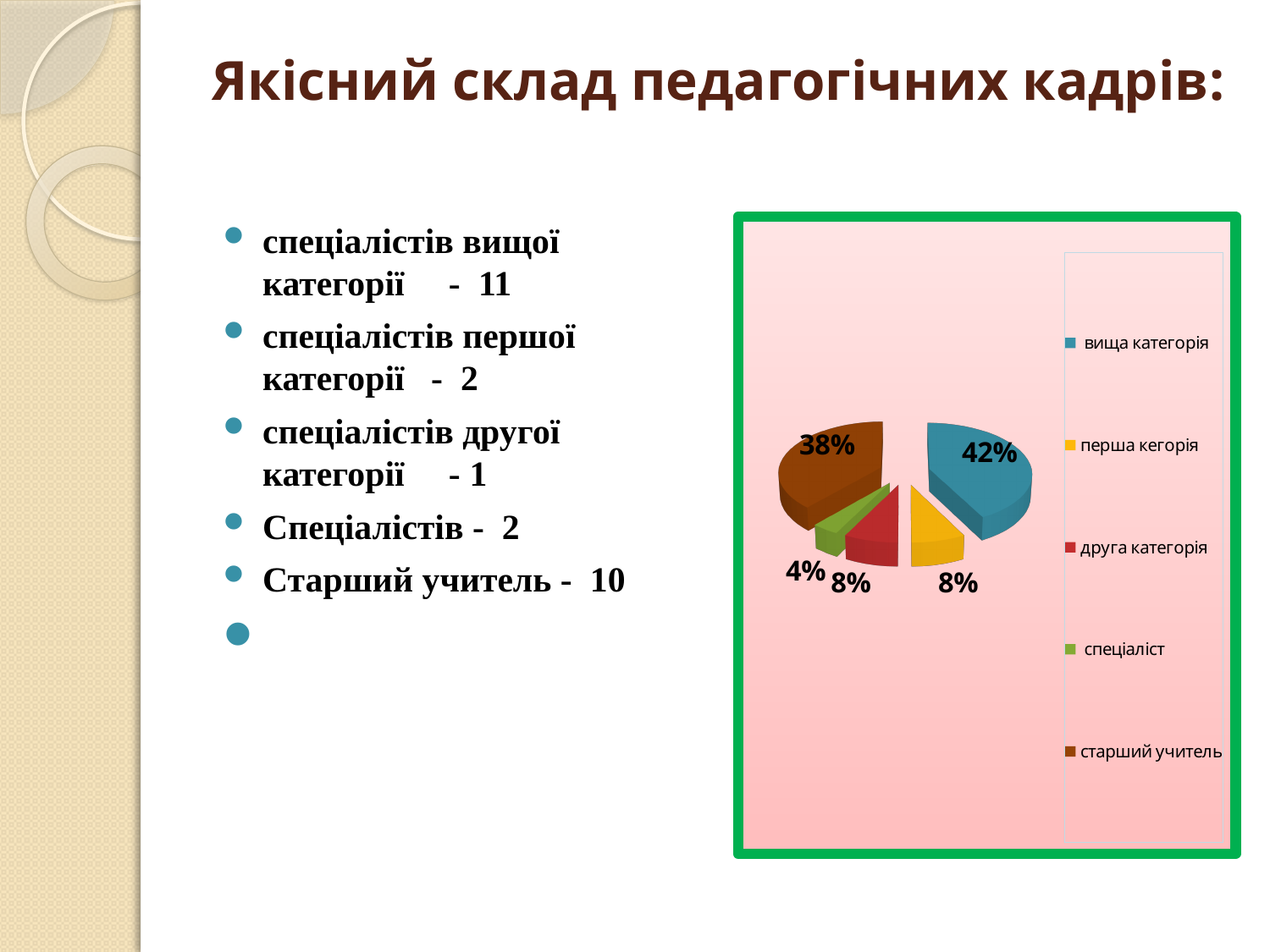
What is the difference in percentage points between the "вища категорія" slice and the "старший учитель" slice? 4 Which category has the largest slice of the pie? вища категорія What share of the pie does the "вища категорія" slice represent? 42% What share of the pie does the "старший учитель" slice represent? 38% What kind of chart is shown on the slide? pie chart How many slices does the pie chart have? 5 What share of the pie does the "друга категорія" slice represent? 8% Which category has the smallest slice of the pie? спеціаліст Which slice is larger: "старший учитель" or "спеціаліст"? старший учитель What colour is the "вища категорія" slice in the pie chart? blue How many entries does the legend list? 5